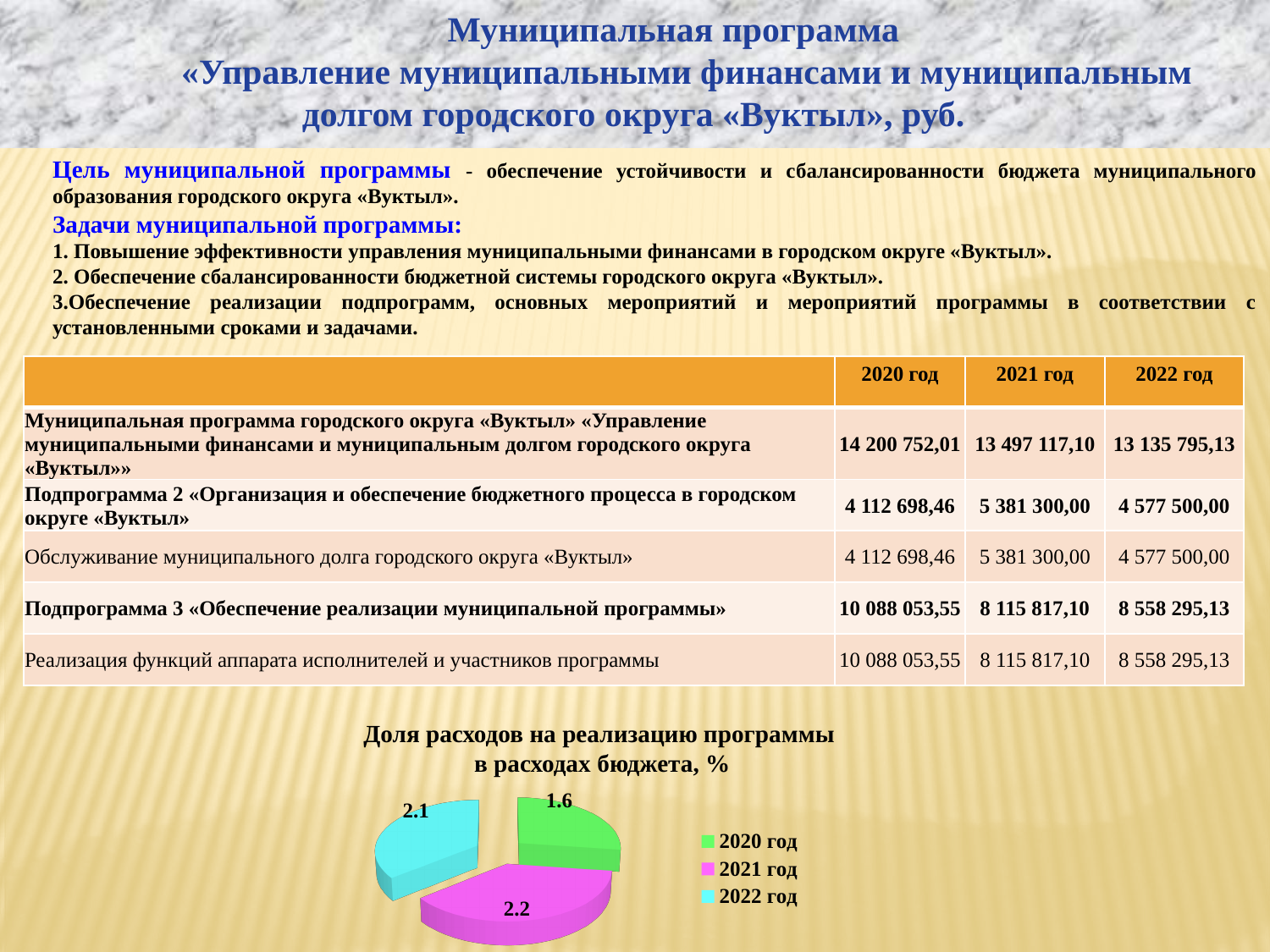
How many slices does the pie chart have? 3 What is the difference between the values for 2021 год and 2020 год in the pie chart? 0.6 What is the value for 2021 год in the pie chart? 2.2 In the pie chart, which is larger: the value for 2021 год or the value for 2022 год? 2021 год What colour is the slice for 2022 год in the pie chart? Cyan (light blue) What kind of chart is shown at the bottom of the slide? Pie chart What is the value for 2020 год in the pie chart "Доля расходов на реализацию программы в расходах бюджета, %"? 1.6 What is the value for 2022 год in the pie chart? 2.1 Which year has the largest slice in the pie chart? 2021 год What is the difference between the values for 2022 год and 2020 год in the pie chart? 0.5 Which year has the smallest slice in the pie chart? 2020 год How many entries does the legend of the pie chart list? 3